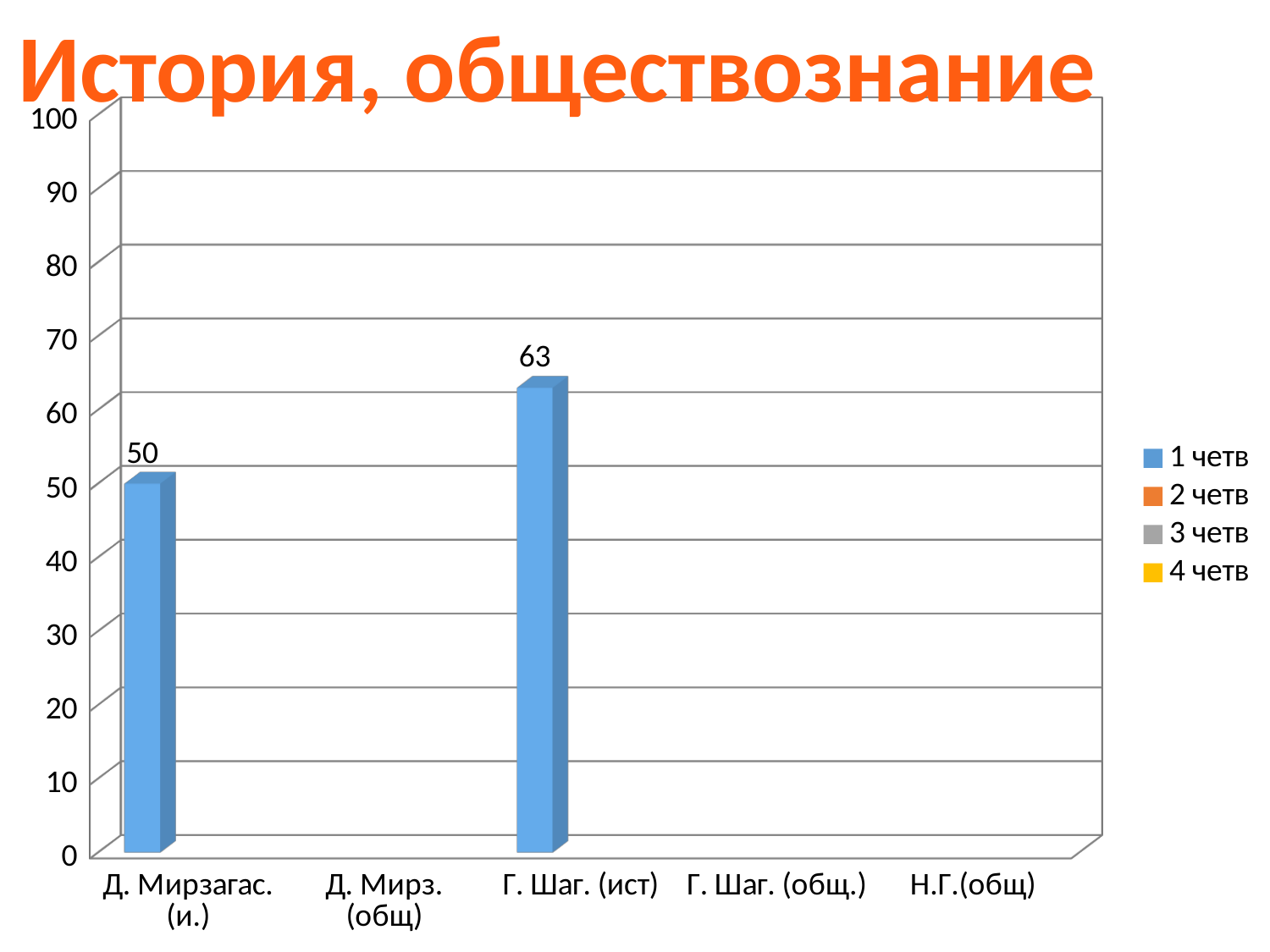
What is the value for Д. Мирзагас. (и.) in the 1 четв series? 50 What is the value for Г. Шаг. (ист) in the 1 четв series? 63 What is the difference between the values for Г. Шаг. (ист) and Д. Мирзагас. (и.)? 13 What kind of chart is shown on the slide? bar chart Which series is shown in blue in the legend? 1 четв Is the value for Д. Мирзагас. (и.) greater or less than 70? less Which is larger, the value for Д. Мирзагас. (и.) or the value for Г. Шаг. (ист)? Г. Шаг. (ист) How many categories are shown on the x axis? 5 Is the value for Г. Шаг. (ист) greater or less than 60? greater What is the title of the chart? История, обществознание Which category has the highest plotted value? Г. Шаг. (ист) How many series does the legend list? 4